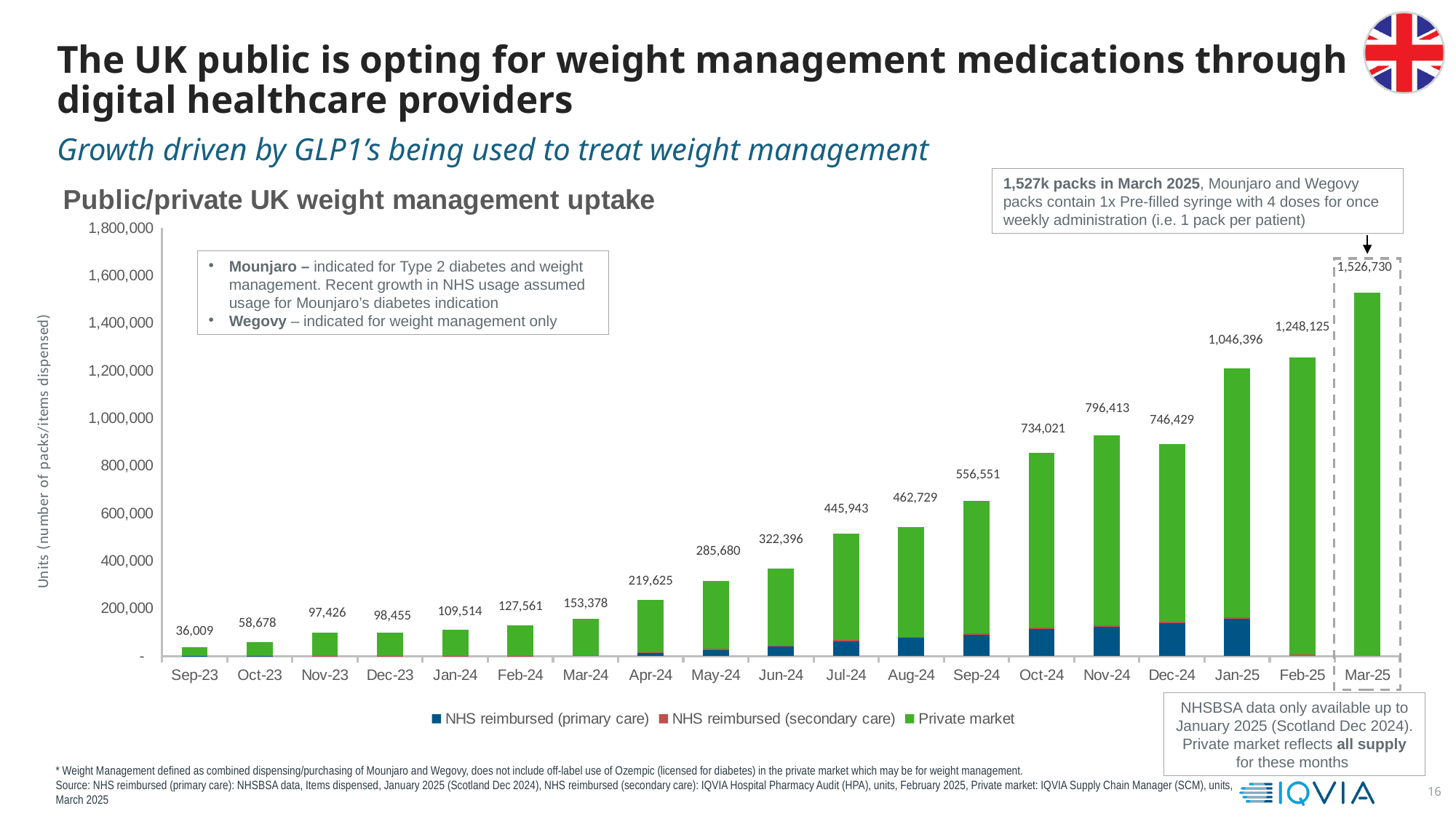
What is the difference between the data labels for Mar-25 and Feb-25? 278,605 Which month has the tallest bar in the chart? Mar-25 What is the data label shown for Sep-23? 36,009 Which month has the shortest bar in the chart? Sep-23 Which bar is taller, Nov-24 or Dec-24? Nov-24 What is the data label shown for Jul-24? 445,943 How many months are shown on the x axis of the chart? 19 What is the data label shown for Mar-25? 1,526,730 Is the total bar height for Oct-24 greater or less than 800,000? greater Do the bar heights generally rise or fall from Sep-23 to Mar-25? Rise How many series does the chart legend list? 3 What type of chart is shown on the slide? Stacked bar chart